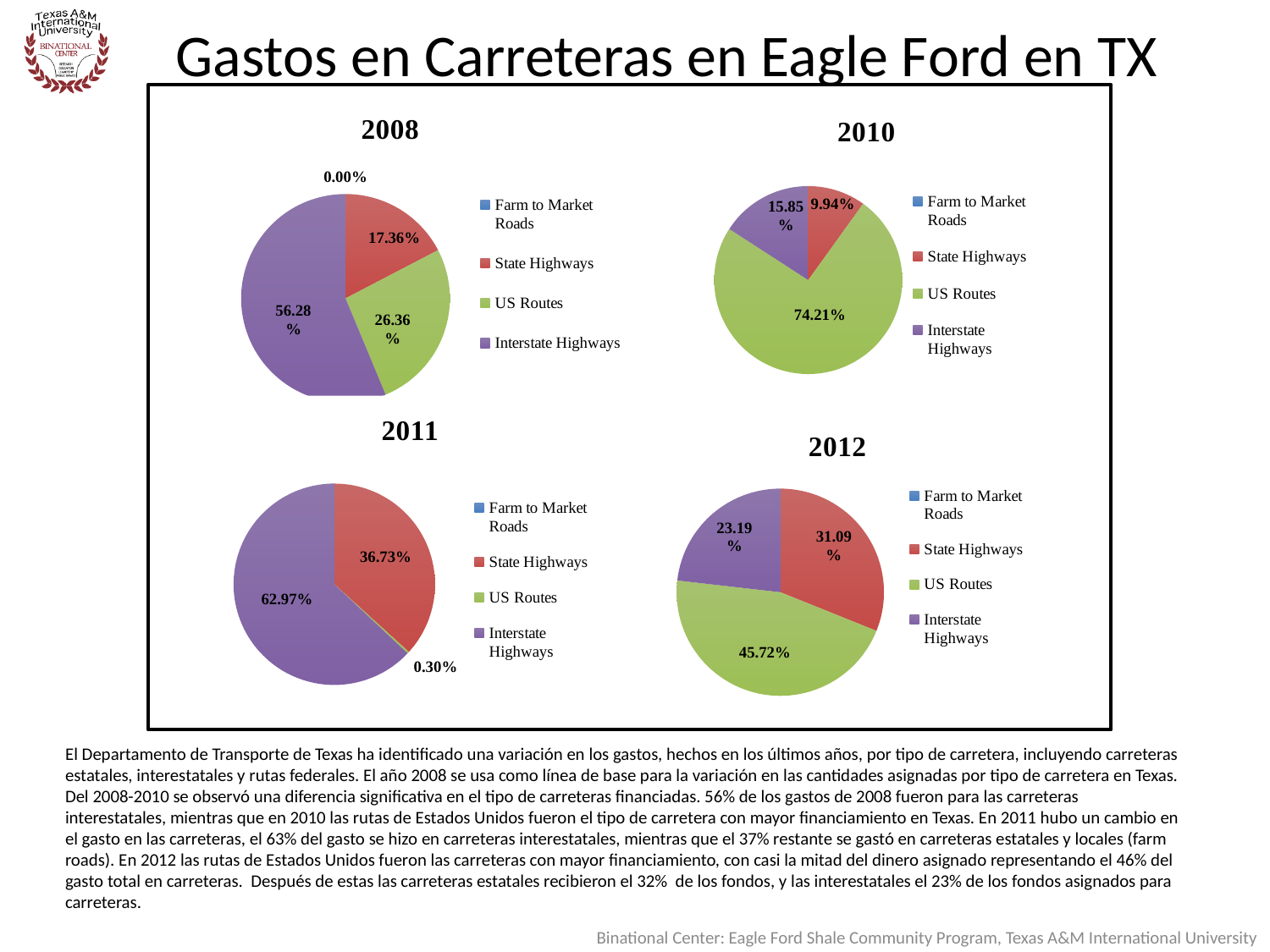
How many categories does the legend of the 2008 pie chart list? 4 In the 2011 pie chart, what share of spending went to Interstate Highways? 62.97% What type of chart is used for the 2010 data? Pie chart In the 2008 pie chart, what share of spending went to Interstate Highways? 56.28% In the 2011 pie chart, what is the difference between the Interstate Highways share and the State Highways share? 26.24% In the 2010 pie chart, what share of spending went to US Routes? 74.21% In the 2008 pie chart, what share of spending went to State Highways? 17.36% In the 2010 pie chart, which category has the largest share? US Routes How many pie charts are shown on the slide? 4 In the 2012 pie chart, what share of spending went to Interstate Highways? 23.19% In the 2012 pie chart, which category has the largest share? US Routes In the 2012 pie chart, which is larger: the State Highways share or the Interstate Highways share? State Highways